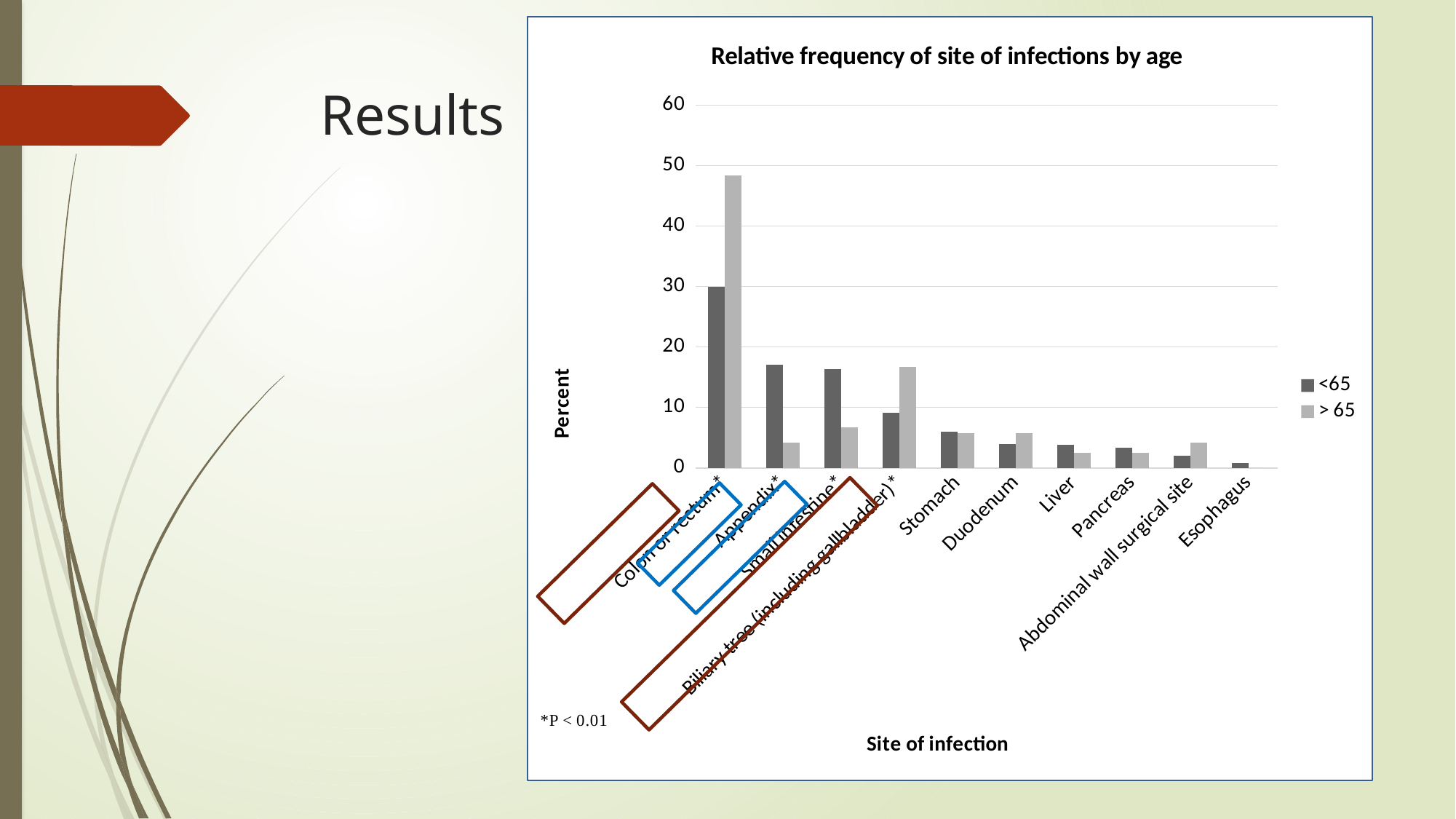
How many series does the legend list? 2 Is the > 65 value for Appendix greater or less than 10? less Which site of infection has the highest value for the <65 series? Colon or rectum Is the > 65 value for Colon or rectum greater or less than 40? greater Is the <65 value for Colon or rectum greater or less than 40? less What kind of chart is shown on the slide? bar chart What is the title of the chart? Relative frequency of site of infections by age For Appendix, which series has the larger value, <65 or > 65? <65 Which site of infection has the lowest value for the <65 series? Esophagus How many sites of infection are shown on the x axis? 10 Which site of infection has the highest value for the > 65 series? Colon or rectum For Biliary tree (including gallbladder), which series has the larger value, <65 or > 65? > 65